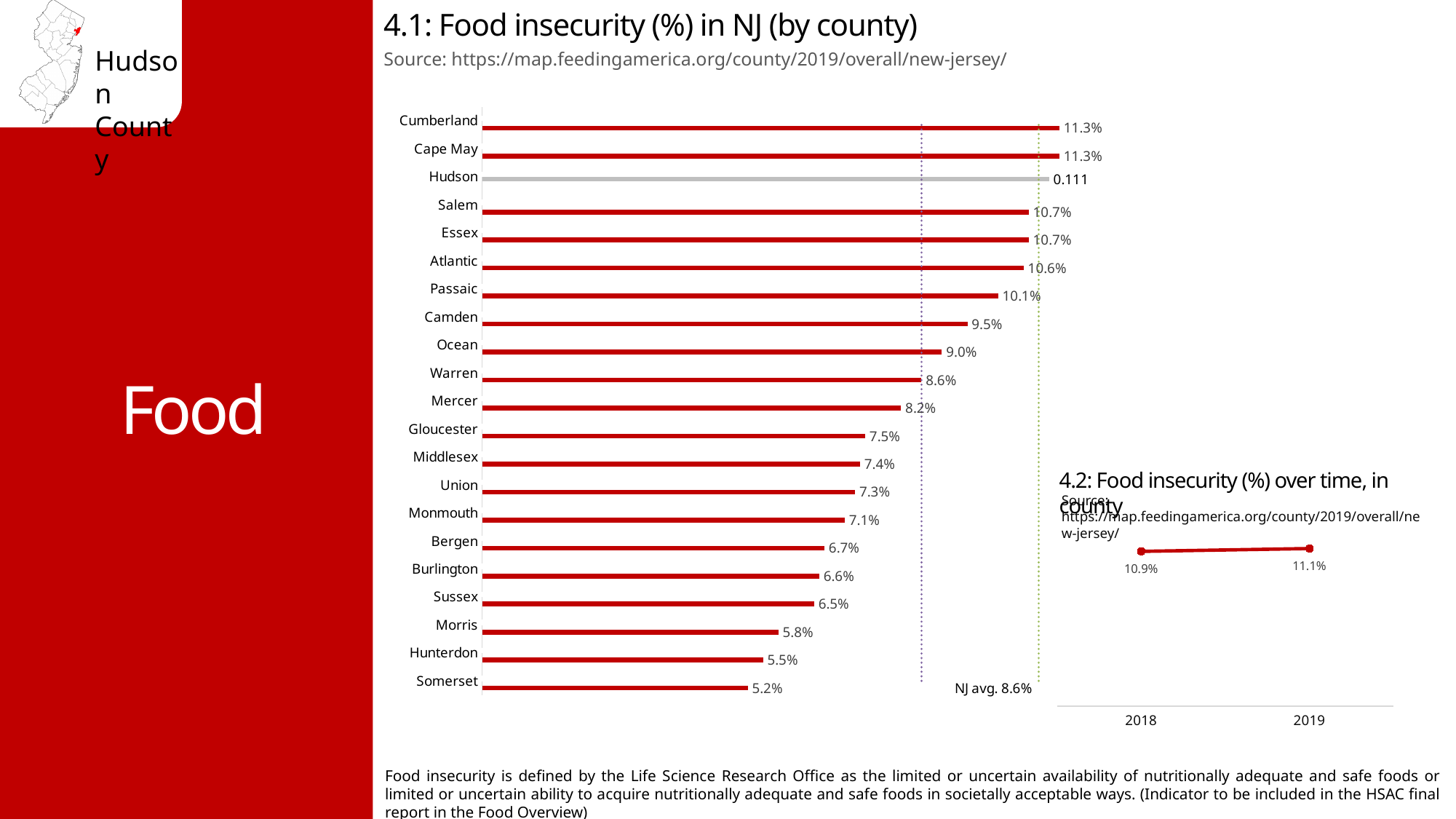
In chart 4.2 (Food insecurity (%) over time, in county), does the value rise or fall from 2018 to 2019? Rise In chart 4.1 (Food insecurity (%) in NJ by county), what is the value for Bergen? 6.7% In chart 4.2 (Food insecurity (%) over time, in county), what is the difference between 2019 and 2018? 0.2% In chart 4.1 (Food insecurity (%) in NJ by county), what is the value shown for Hudson? 0.111 What kind of chart is chart 4.1 (Food insecurity (%) in NJ by county)? Bar chart In chart 4.1 (Food insecurity (%) in NJ by county), which is larger, Ocean or Gloucester? Ocean In chart 4.2 (Food insecurity (%) over time, in county), what is the value for 2018? 10.9% In chart 4.1 (Food insecurity (%) in NJ by county), what NJ average is labelled on the chart? 8.6% In chart 4.1 (Food insecurity (%) in NJ by county), which county has the lowest value? Somerset In chart 4.1 (Food insecurity (%) in NJ by county), how many counties are plotted? 21 In chart 4.1 (Food insecurity (%) in NJ by county), what is the difference between Camden and Mercer? 1.3% In chart 4.1 (Food insecurity (%) in NJ by county), what is the value for Passaic? 10.1%